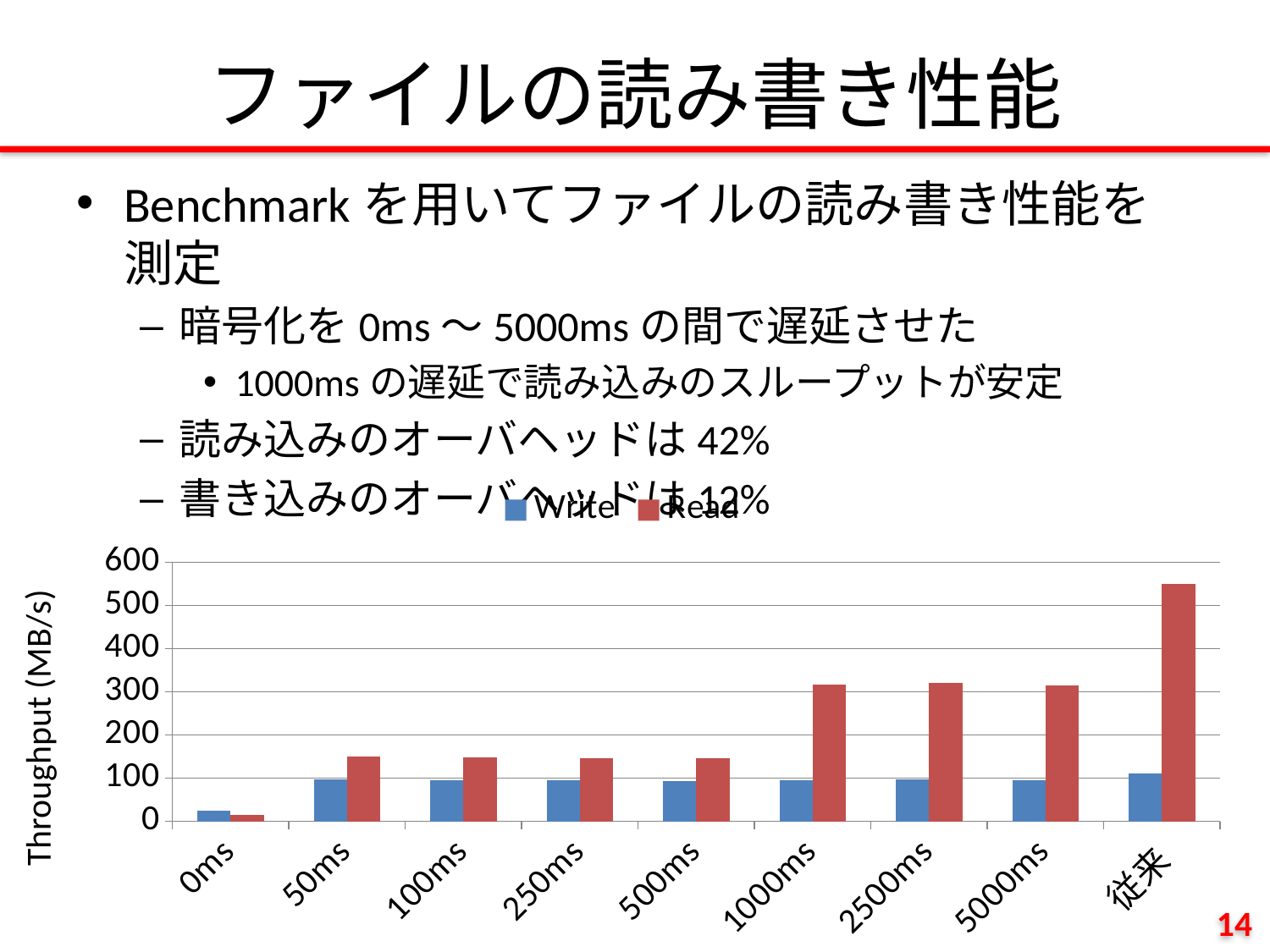
Which category has the highest Read value? 従来 Is the Read value for 500ms greater or less than 200? less How many categories are shown along the x axis of the chart? 9 At 2500ms, which is larger, the Write value or the Read value? Read What is the label of the vertical axis of the chart? Throughput (MB/s) Which category has the lowest Read value? 0ms Is the Read value for 1000ms greater or less than 300? greater What kind of chart is shown on the slide? bar chart Which category has the lowest Write value? 0ms How many series does the chart legend list? 2 Is the Read value for 従来 greater or less than 500? greater